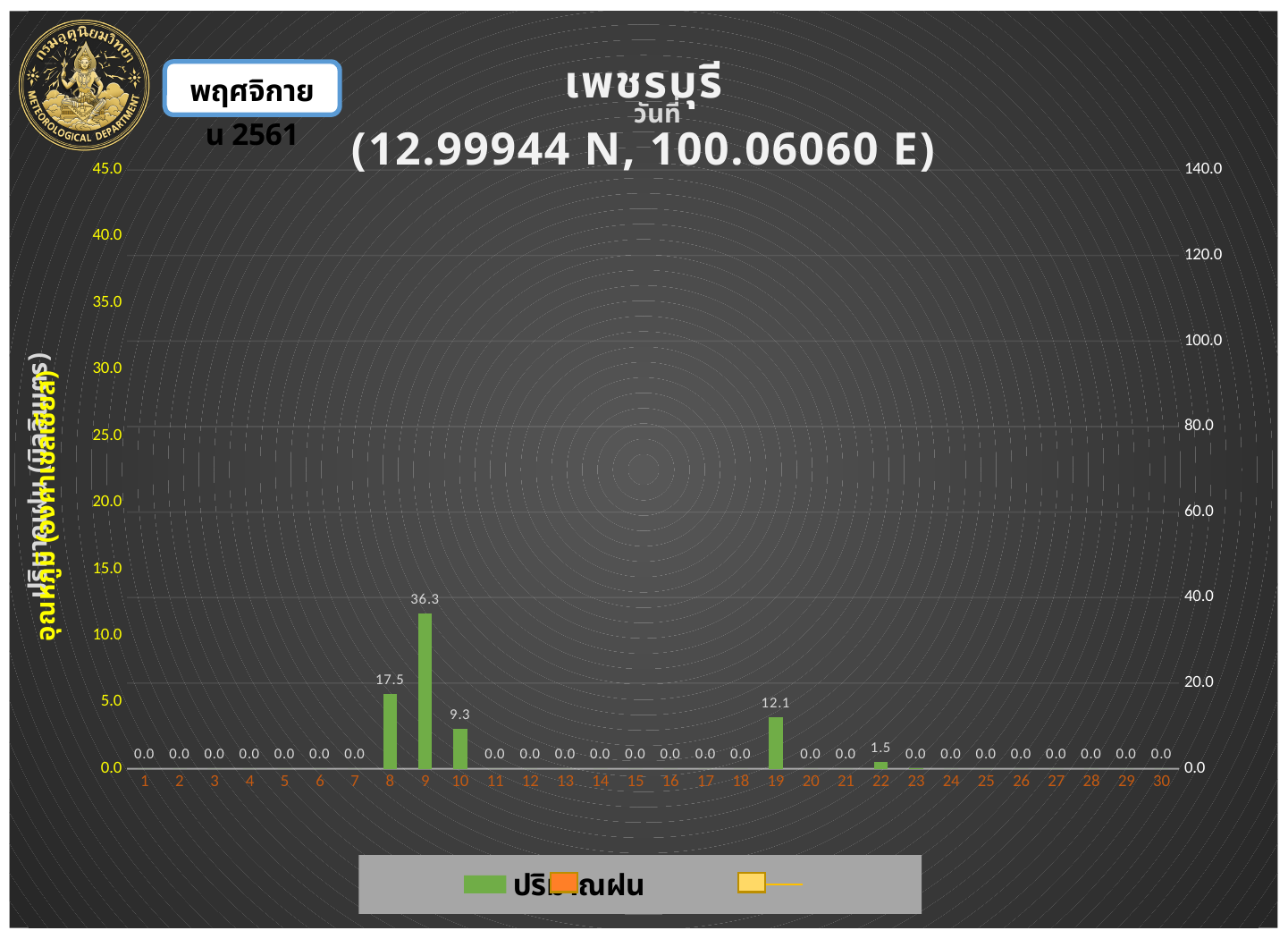
Which is larger, the rainfall value for day 8 or for day 19? day 8 What is the rainfall value shown for day 19? 12.1 What station name is given in the chart title? เพชรบุรี What kind of chart is used to show the rainfall values? bar chart How many days are shown on the x axis? 30 What is the difference between the rainfall values for day 9 and day 8? 18.8 What is the rainfall value shown for day 9? 36.3 What is the rainfall value shown for day 8? 17.5 What is the rainfall value shown for day 10? 9.3 What is the rainfall value shown for day 22? 1.5 What is the difference between the rainfall values for day 19 and day 10? 2.8 Which day has the highest rainfall value? 9